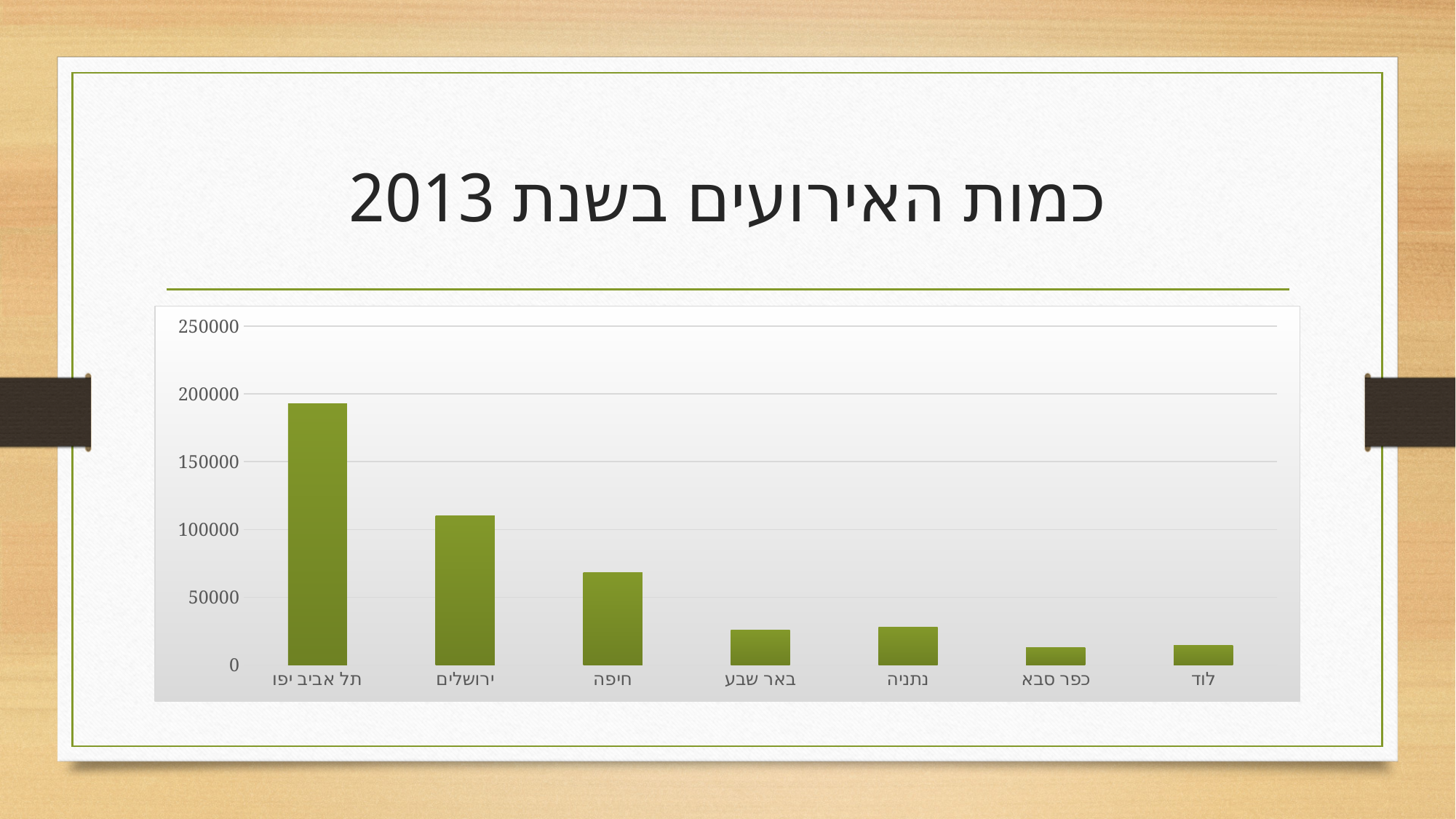
Is the value for ירושלים greater or less than 100000? greater Which is larger, the value for ירושלים or the value for חיפה? ירושלים Which is larger, the value for נתניה or the value for כפר סבא? נתניה Is the value for חיפה greater or less than 100000? less Is the value for תל אביב יפו greater or less than 200000? less How many cities are shown on the x axis of the chart? 7 What kind of chart is shown on the slide? bar chart Which city has the highest bar in the chart? תל אביב יפו What is the title of the slide? כמות האירועים בשנת 2013